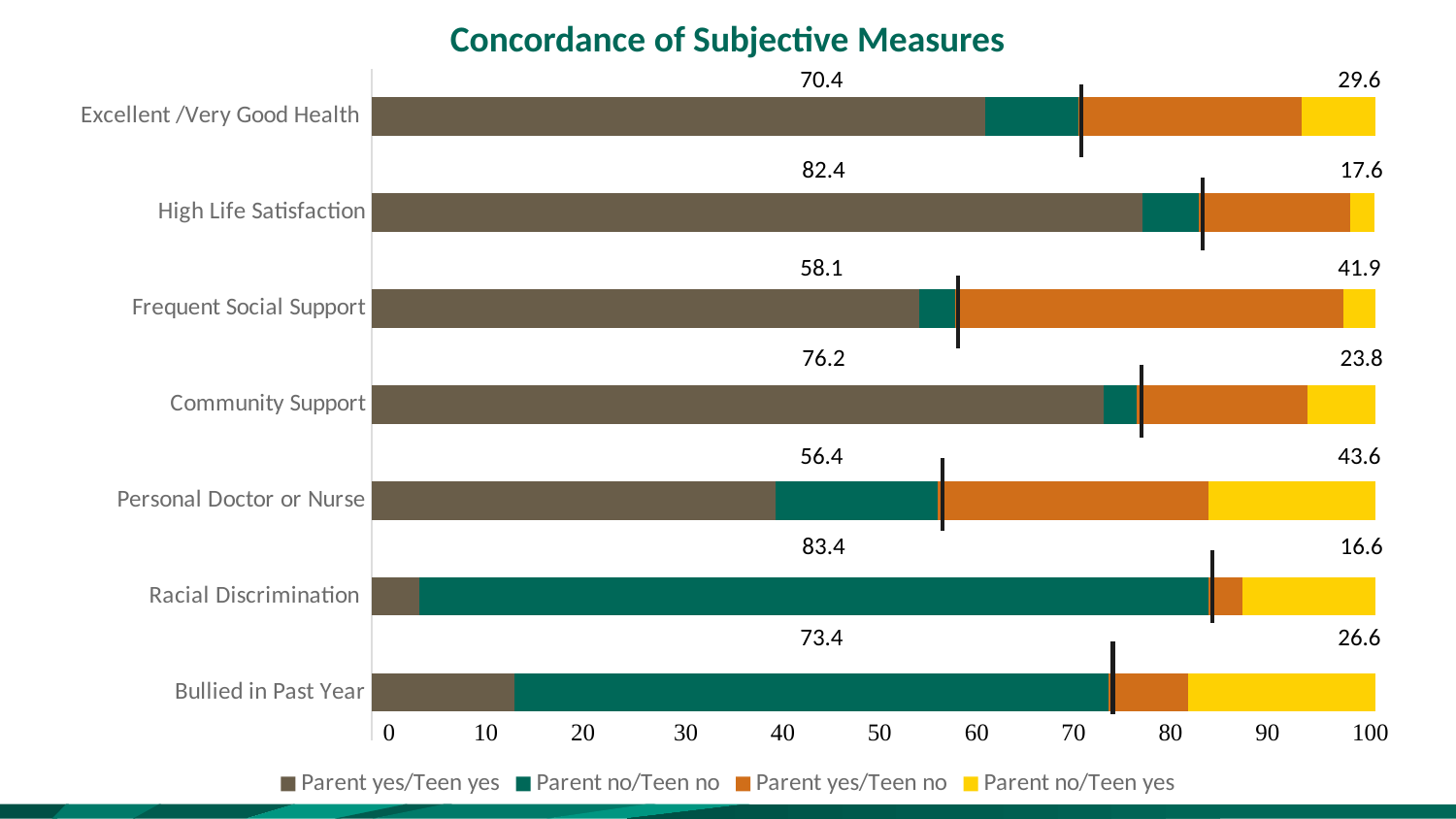
What kind of chart is shown on the slide? bar chart What value is printed on the right above the bar for Personal Doctor or Nurse? 43.6 What value is printed on the left above the bar for High Life Satisfaction? 82.4 Which has the larger left-printed value, Frequent Social Support or Community Support? Community Support Which category has the highest value printed on the left above its bar? Racial Discrimination How many categories (measures) are plotted on the chart? 7 What is the difference between the left-printed values for High Life Satisfaction (82.4) and Excellent/Very Good Health (70.4)? 12 Which colour represents Parent no/Teen yes in the legend? yellow Does the Parent yes/Teen yes segment for Bullied in Past Year end at a value greater or less than 20? less How many series does the legend list? 4 Which category has the lowest value printed on the left above its bar? Personal Doctor or Nurse What is the title of the chart? Concordance of Subjective Measures